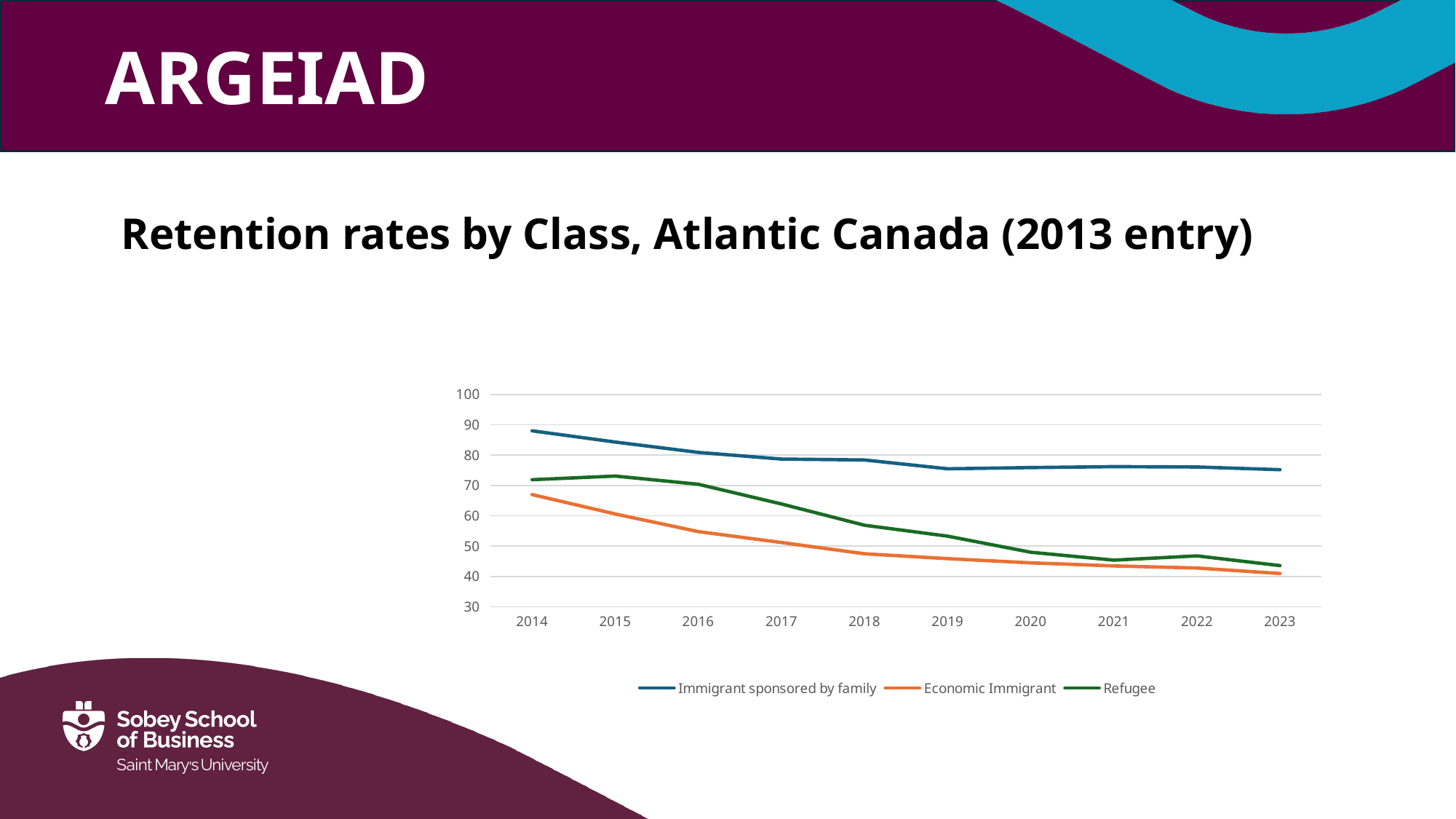
Does the Economic Immigrant line rise or fall from 2014 to 2023? fall Is the value for Refugee in 2018 greater or less than 50? greater Is the value for Economic Immigrant in 2023 greater or less than 50? less How many years are shown along the x axis? 10 Which series has the lowest retention rate in 2014? Economic Immigrant How many series does the legend list? 3 What kind of chart is shown on the slide? line chart In 2016, which is higher: Refugee or Economic Immigrant? Refugee What is the title of the chart? Retention rates by Class, Atlantic Canada (2013 entry) Is the value for Immigrant sponsored by family in 2014 greater or less than 80? greater Which series is drawn in orange? Economic Immigrant Which series has the highest retention rate in 2023? Immigrant sponsored by family